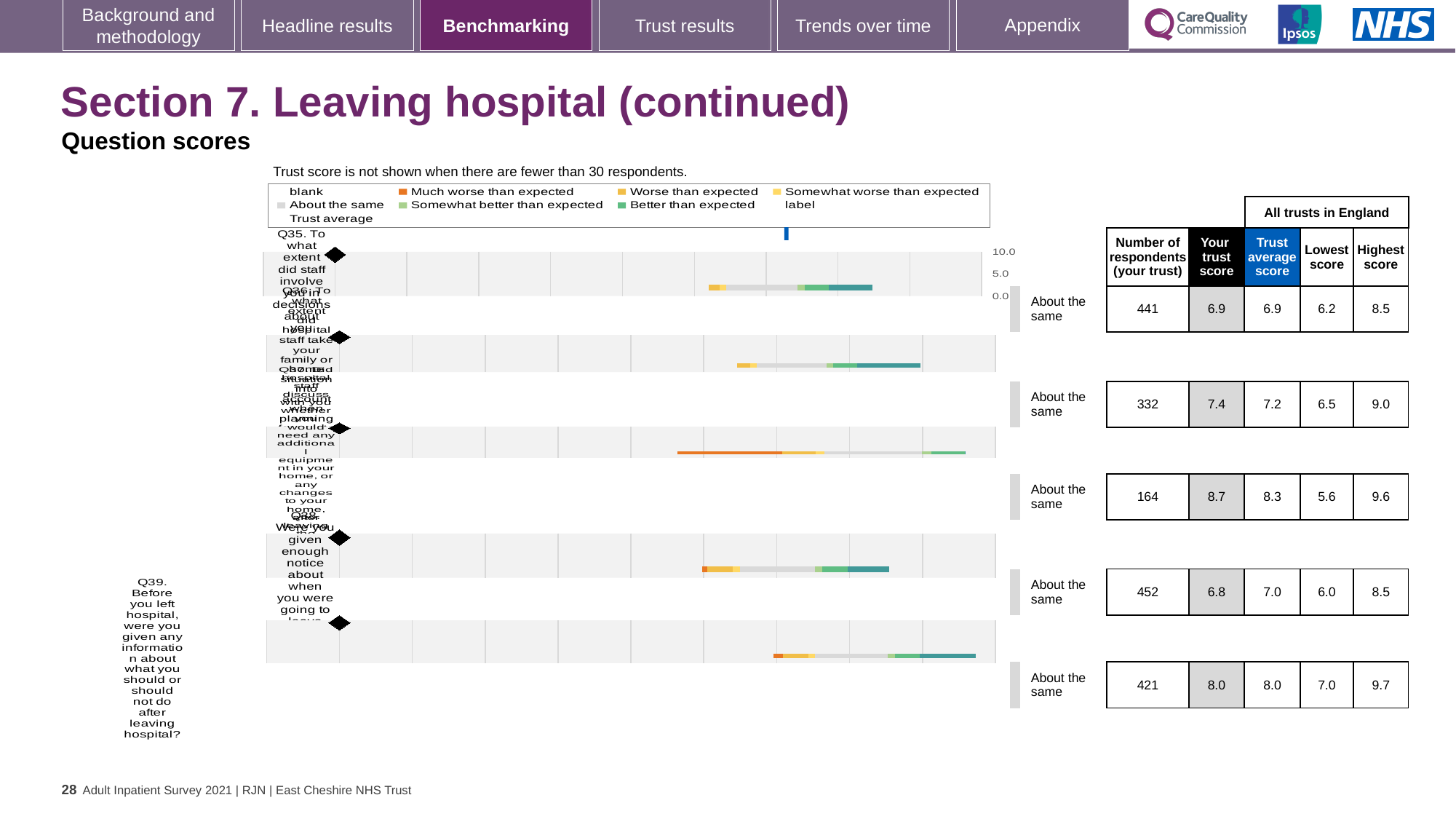
What is the lowest 'Your trust score' value shown in the table? 6.8 What is the 'Your trust score' for Q39 (Before you left hospital, were you given any information about what you should or should not do after leaving hospital)? 8.0 What is the 'Your trust score' for Q35 (To what extent did staff involve you in decisions about you leaving hospital)? 6.9 What is the highest 'Your trust score' value shown in the table? 8.7 Which has the larger 'Your trust score': Q35 or Q39? Q39 Is the trust score for Q39 greater or less than 5.0? greater How many questions (rows) are shown in the question scores chart? 5 For Q39, what is the difference between the highest score and the lowest score across all trusts in England? 2.7 What benchmark category is shown for Q35? About the same What kind of chart is used to show the question scores on this slide? bar chart What is the title of the slide? Section 7. Leaving hospital (continued) How many respondents from your trust answered Q39? 421